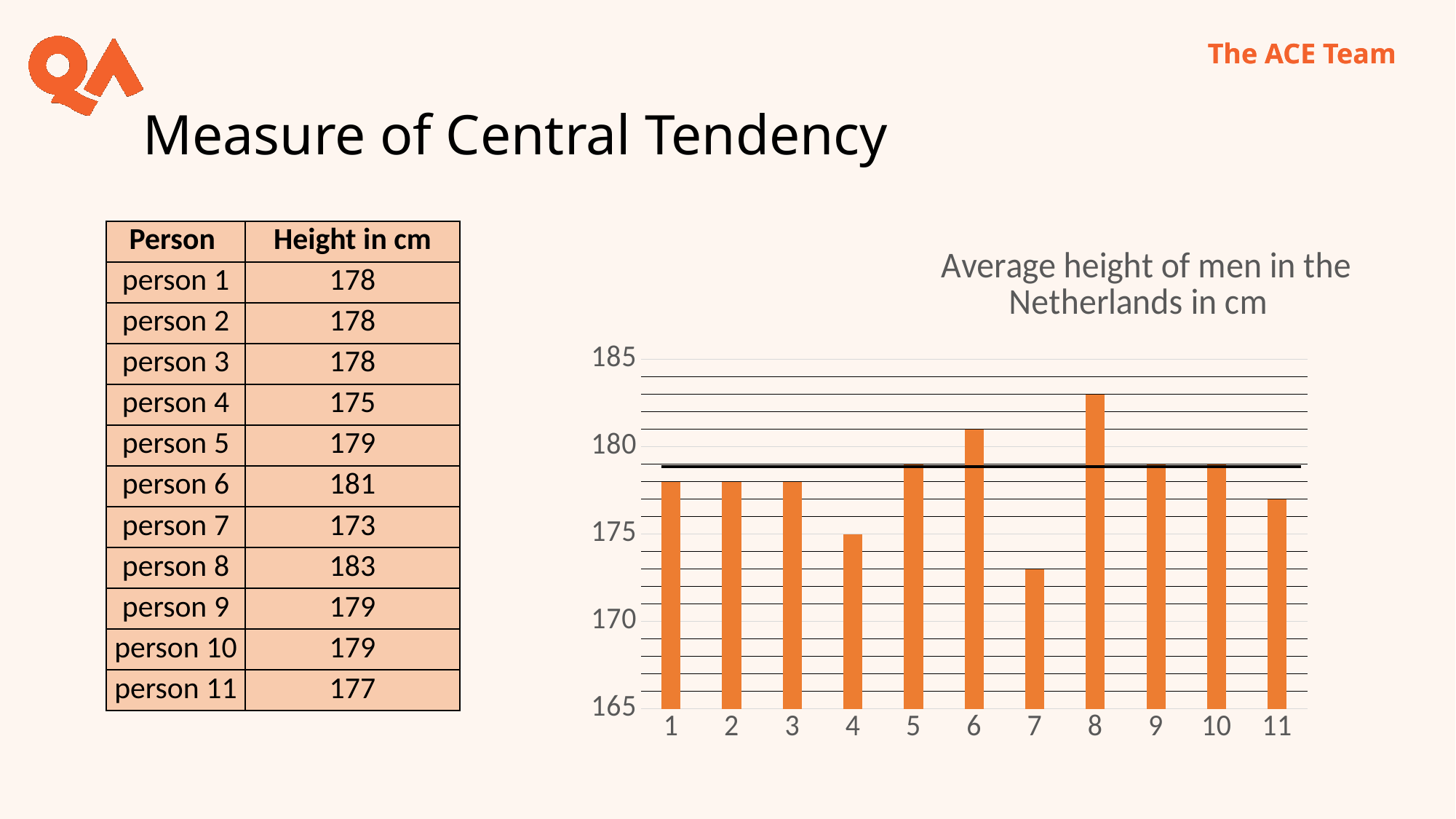
Which is taller, person 6 or person 4? person 6 Which person has the shortest bar in the chart? 7 What is the height in cm for person 8? 183 What is the height in cm for person 4? 175 What is the difference in cm between the heights of person 8 and person 7? 10 How many bars does the chart have? 11 What is the height in cm for person 7? 173 Which person has the tallest bar in the chart? 8 Is the bar for person 11 greater or less than 180? less What kind of chart is shown on the slide? bar chart What is the title of the chart? Average height of men in the Netherlands in cm Is the bar for person 6 greater or less than 180? greater